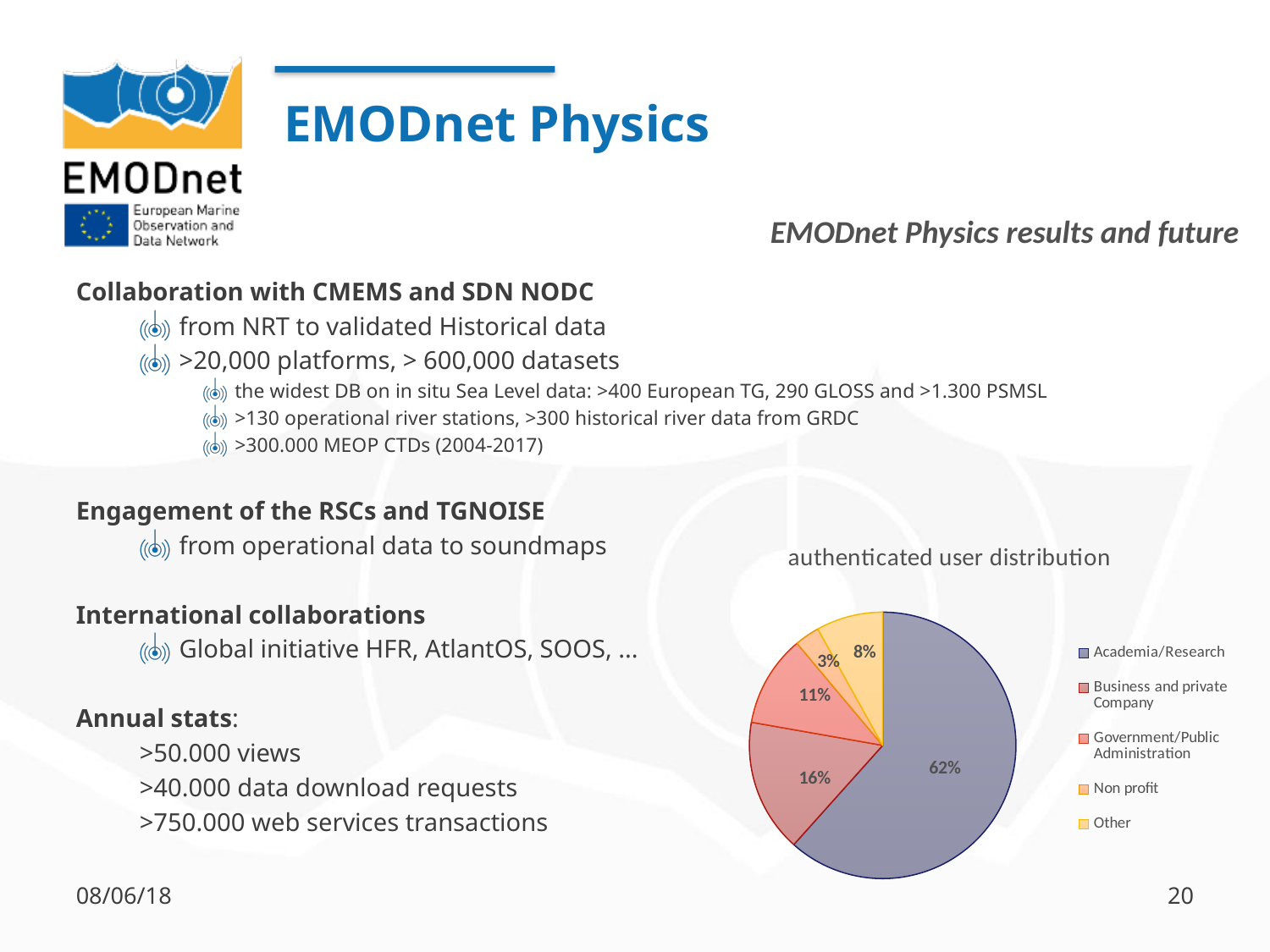
What share of authenticated users is Business and private Company? 16% How many categories does the pie chart legend list? 5 Which is larger, the share for Government/Public Administration or the share for Other? Government/Public Administration What is the difference in percentage points between the Academia/Research share and the Business and private Company share? 46 What share of authenticated users is Non profit? 3% Which category has the smallest share of authenticated users? Non profit What share of authenticated users is Other? 8% Which category has the largest share of authenticated users? Academia/Research What is the title of the pie chart? authenticated user distribution What kind of chart is shown on the slide? pie chart